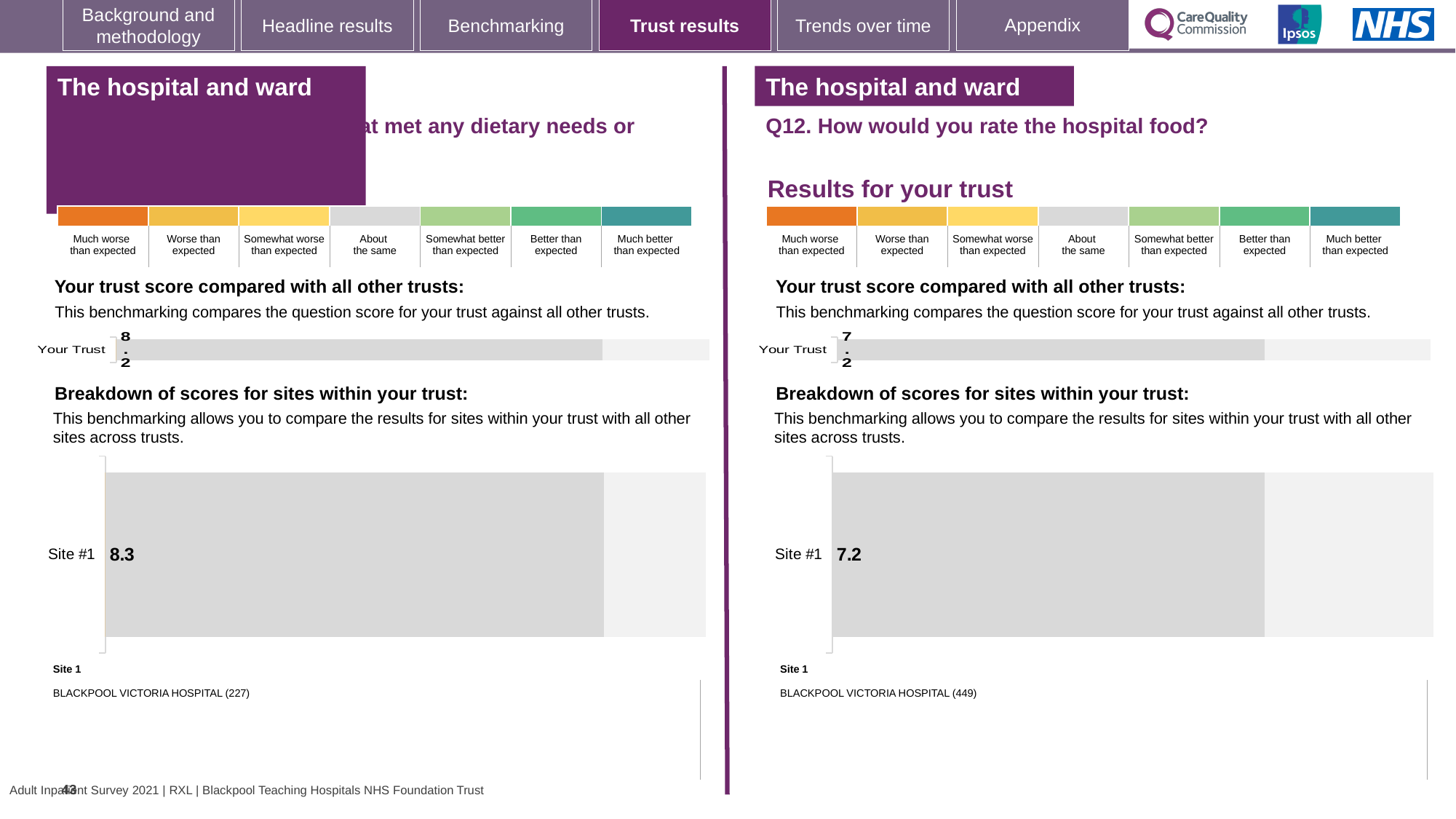
What is the difference between the 'Your Trust' score on the left-hand side of the slide (8.2) and the 'Your Trust' score on the right-hand side (7.2)? 1.0 On the left-hand side of the slide, what score is shown for Site #1 in the site breakdown chart? 8.3 Which site is listed as Site 1 beneath the site breakdown chart on the right-hand side of the slide (Q12)? BLACKPOOL VICTORIA HOSPITAL (449) What type of chart is used to show the Site #1 score on the left-hand side of the slide? Bar chart On the left-hand side of the slide, what is the 'Your Trust' score shown in the trust benchmarking bar chart? 8.2 What is the difference between the Site #1 score on the left-hand side of the slide (8.3) and the Site #1 score on the right-hand side (7.2)? 1.1 On the right-hand side of the slide (Q12, hospital food), what score is shown for Site #1 in the site breakdown chart? 7.2 How many sites are shown in the site breakdown chart on the right-hand side of the slide (Q12)? 1 How many benchmark categories are shown in the colour scale above the charts on the right-hand side of the slide (Q12)? 7 Which is larger: the Site #1 score on the left-hand side of the slide or the Site #1 score on the right-hand side (Q12)? Left-hand side (8.3) On the right-hand side of the slide (Q12, hospital food), what is the 'Your Trust' score shown in the trust benchmarking bar chart? 7.2